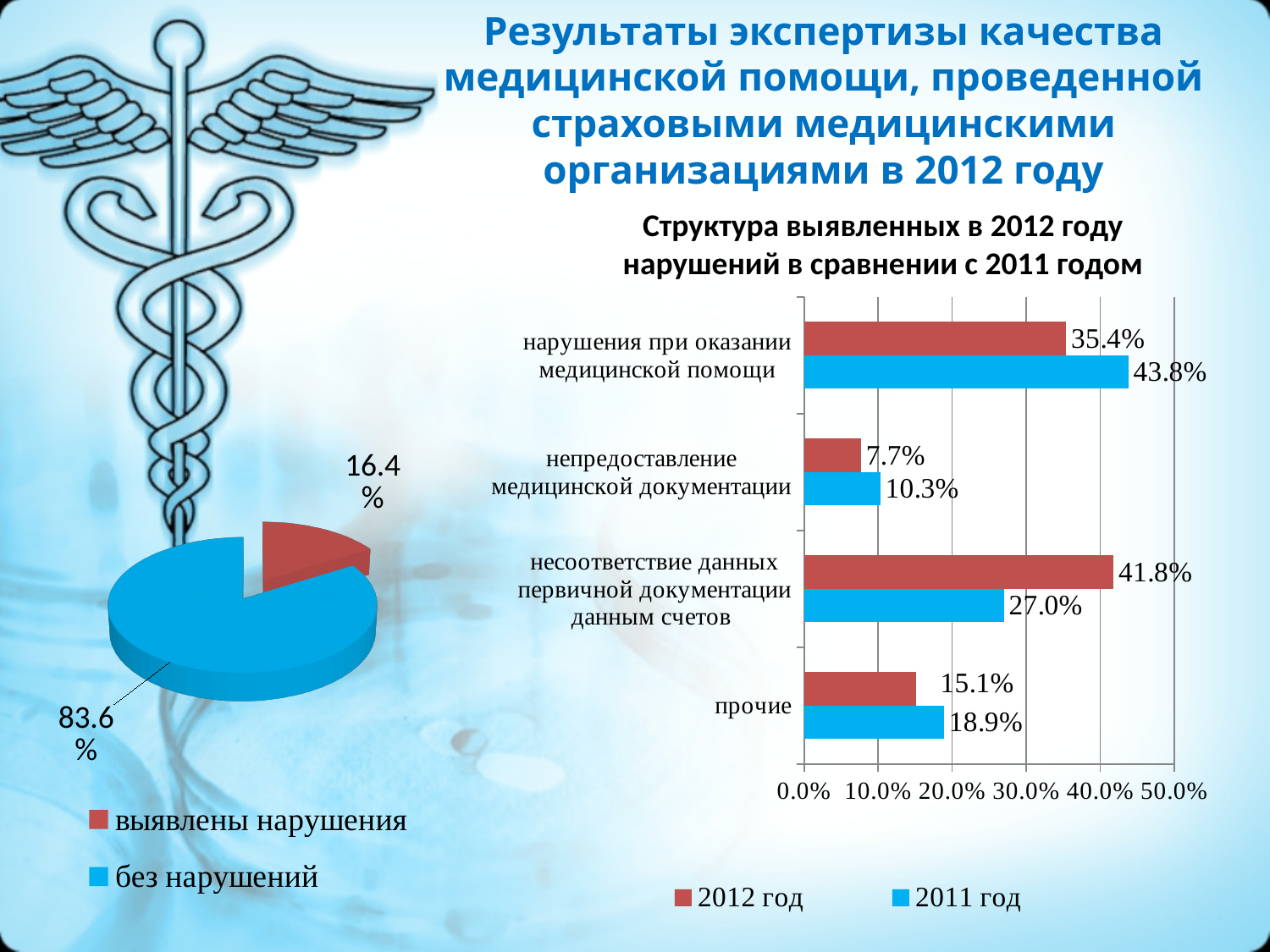
In the pie chart on the left, which slice is larger: 'выявлены нарушения' or 'без нарушений'? без нарушений In the bar chart on the right, what is the value for 'прочие' in 2012 год? 15.1% In the bar chart on the right, how many series does the legend list? 2 In the bar chart on the right, how many categories are shown? 4 In the bar chart on the right, which category has the lowest value for 2011 год? непредоставление медицинской документации In the pie chart on the left, what share does 'выявлены нарушения' have? 16.4% In the bar chart on the right, which category has the highest value for 2012 год? несоответствие данных первичной документации данным счетов In the bar chart on the right, what is the difference between the 2011 год and 2012 год values for 'нарушения при оказании медицинской помощи'? 8.4% In the bar chart on the right, which year has the larger value for 'несоответствие данных первичной документации данным счетов'? 2012 год What kind of chart is the chart on the right of the slide? bar chart In the bar chart 'Структура выявленных в 2012 году нарушений в сравнении с 2011 годом', what is the value for 'нарушения при оказании медицинской помощи' in 2012 год? 35.4% In the bar chart on the right, what is the value for 'непредоставление медицинской документации' in 2011 год? 10.3%